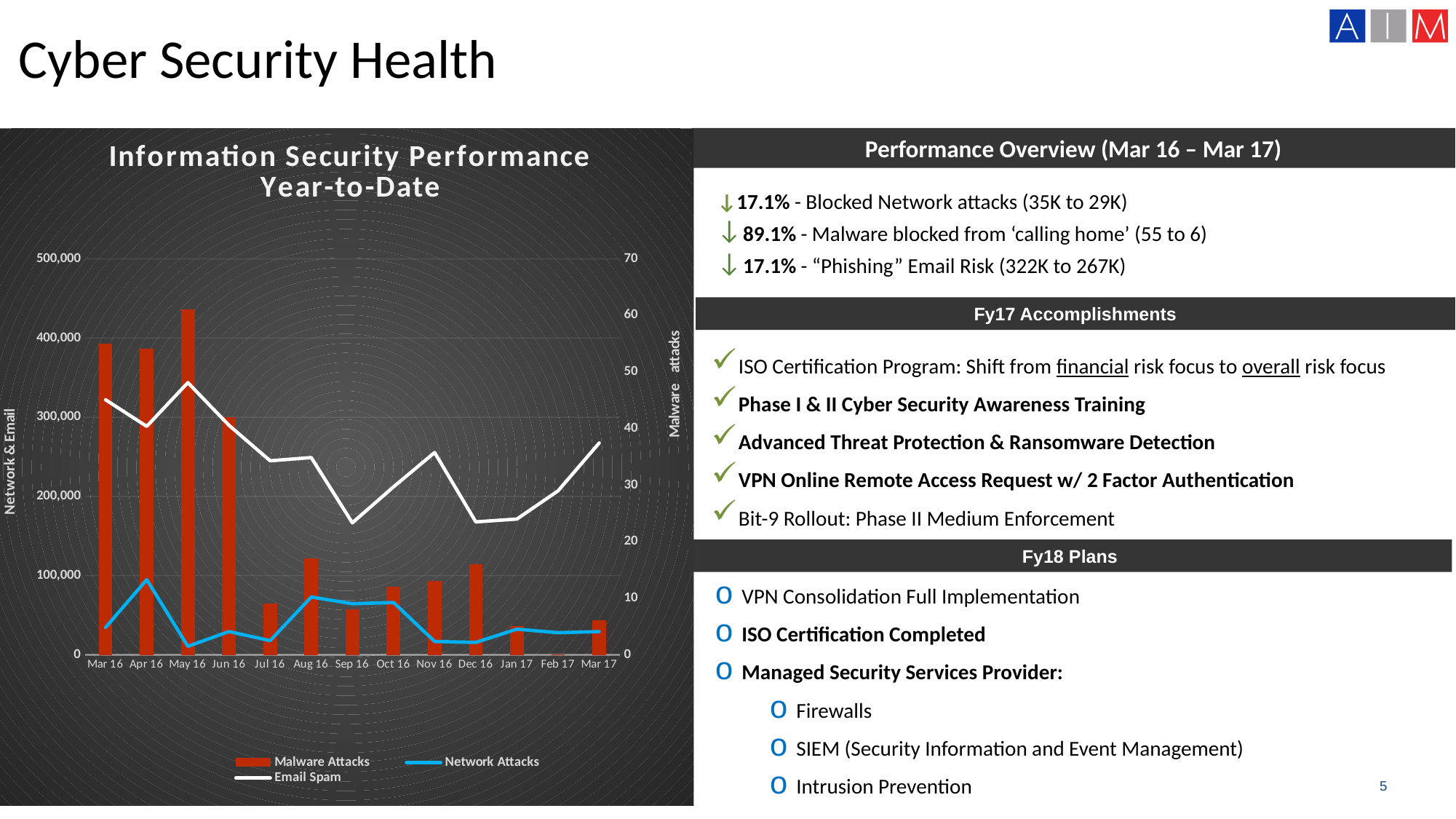
What is the title of the chart on the slide? Information Security Performance Year-to-Date In which month does the Network Attacks line reach its highest point? Apr 16 In which month does the Email Spam line reach its highest point? May 16 Is the Malware Attacks value for May 16 greater or less than 50 on the Malware attacks axis? greater Is the Email Spam value for Sep 16 greater or less than 200,000? less How many series does the chart legend list? 3 How many months are shown along the x axis of the chart? 13 In which month is the Malware Attacks bar highest? May 16 Does the Email Spam line generally rise or fall from Mar 16 to Sep 16? fall What kind of chart is shown on the slide? Combined bar and line chart Which month has the larger Malware Attacks bar, Apr 16 or May 16? May 16 Which series is plotted as bars in the chart? Malware Attacks